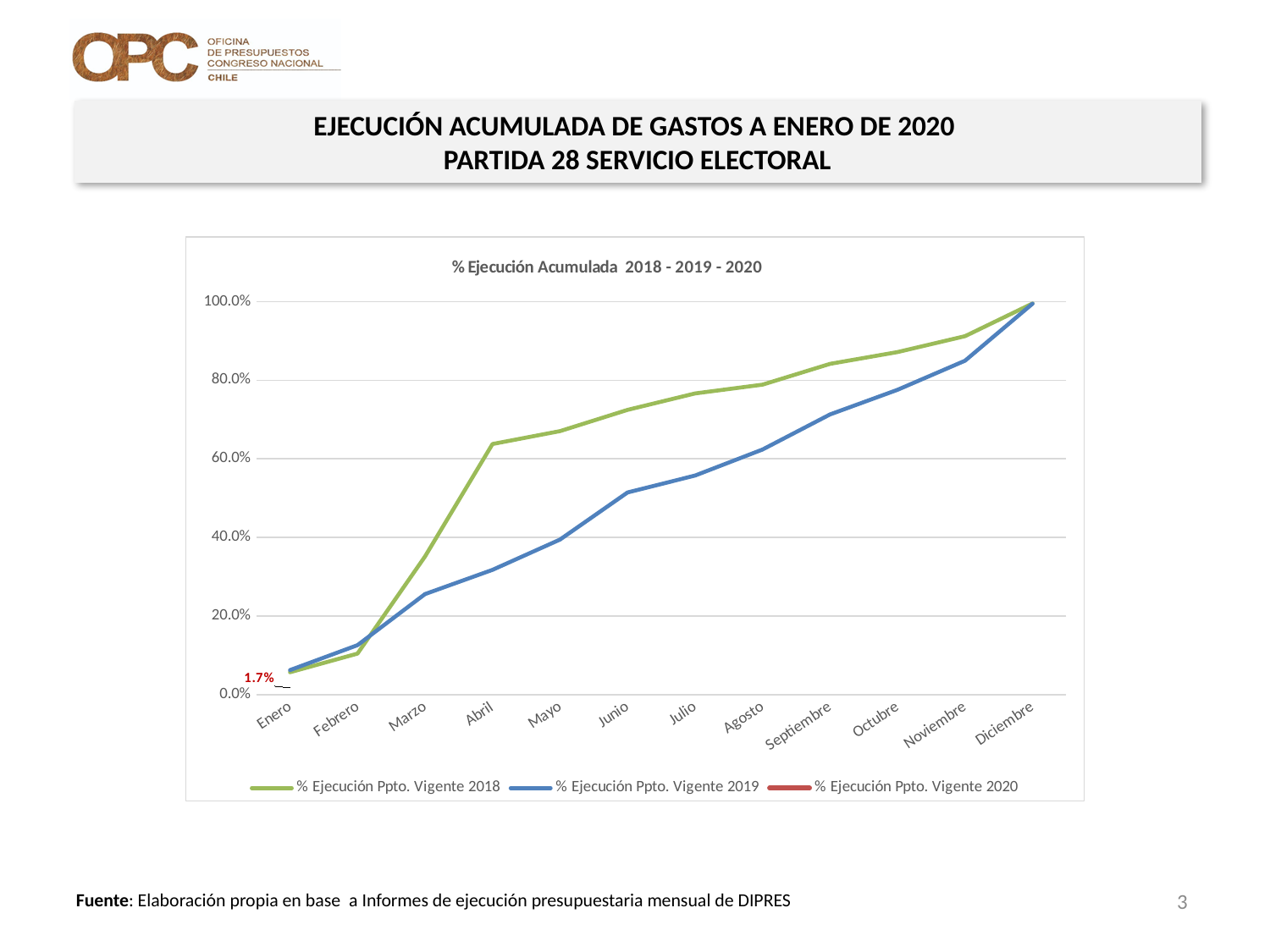
In which month does % Ejecución Ppto. Vigente 2019 reach its highest value? Diciembre In Octubre, which series has the larger value: % Ejecución Ppto. Vigente 2018 or % Ejecución Ppto. Vigente 2019? % Ejecución Ppto. Vigente 2018 How many months are shown along the x axis? 12 Is the value for % Ejecución Ppto. Vigente 2018 in Abril greater or less than 60.0%? greater What kind of chart is shown on the slide? line chart How many series does the legend list? 3 In Abril, which series has the larger value: % Ejecución Ppto. Vigente 2018 or % Ejecución Ppto. Vigente 2019? % Ejecución Ppto. Vigente 2018 What is the value for % Ejecución Ppto. Vigente 2020 in Enero? 1.7% What is the title of the chart? % Ejecución Acumulada 2018 - 2019 - 2020 Is the value for % Ejecución Ppto. Vigente 2019 in Noviembre greater or less than 80.0%? greater Is the value for % Ejecución Ppto. Vigente 2019 in Abril greater or less than 40.0%? less Do the values for % Ejecución Ppto. Vigente 2018 rise or fall from Enero to Diciembre? rise